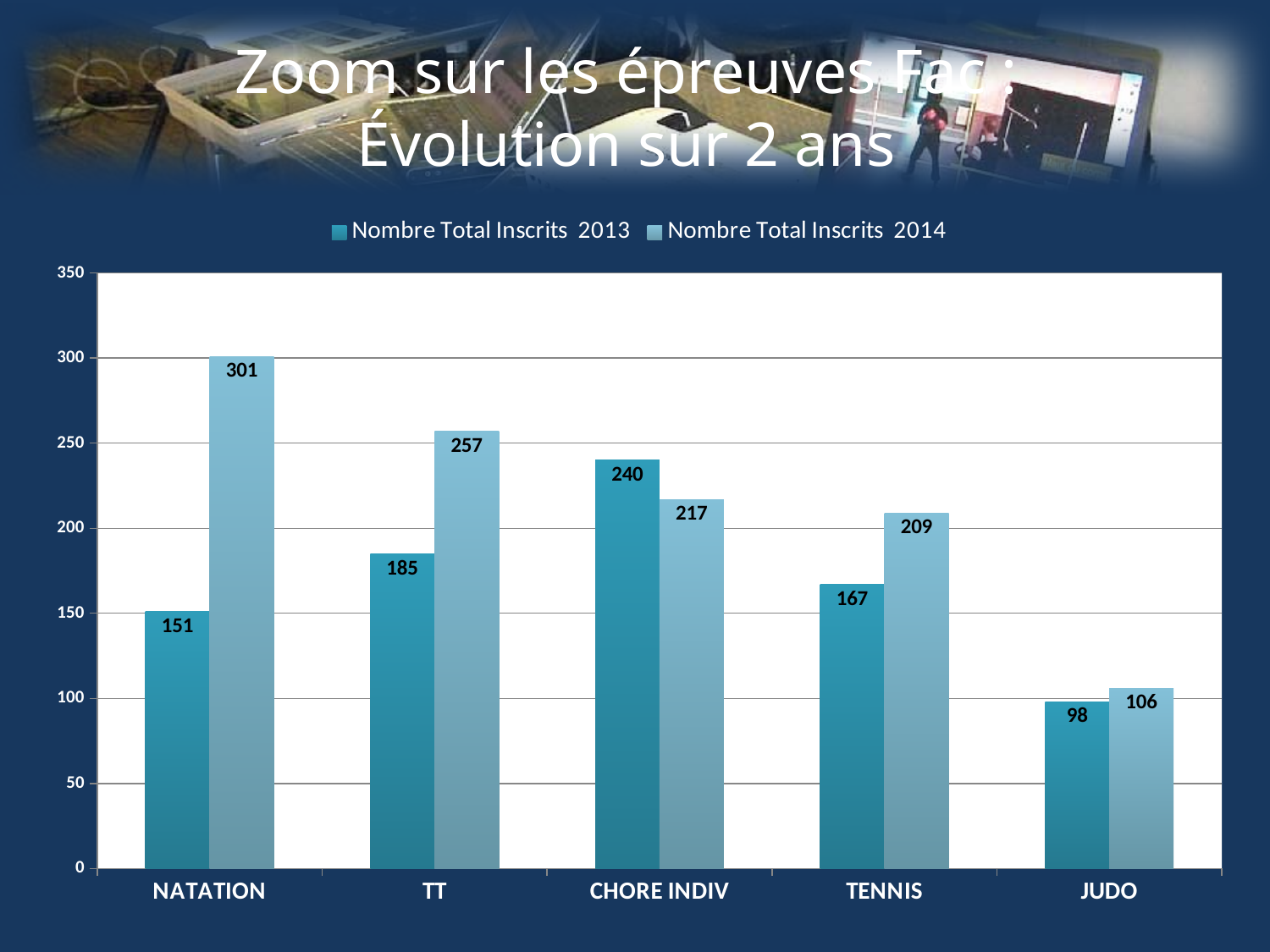
Which category has the lowest value in the Nombre Total Inscrits 2014 series? JUDO How many series does the legend list? 2 Which category has the highest value in the Nombre Total Inscrits 2013 series? CHORE INDIV What kind of chart is shown on the slide? bar chart What is the value for CHORE INDIV in the Nombre Total Inscrits 2013 series? 240 What is the value for NATATION in the Nombre Total Inscrits 2014 series? 301 Which is larger for TENNIS: the 2013 value or the 2014 value? 2014 Is the value for TT in the Nombre Total Inscrits 2014 series greater or less than 250? greater What is the difference between the 2013 and 2014 values for CHORE INDIV? 23 What is the difference between the 2014 and 2013 values for NATATION? 150 What is the value for JUDO in the Nombre Total Inscrits 2014 series? 106 How many categories are shown on the x axis? 5